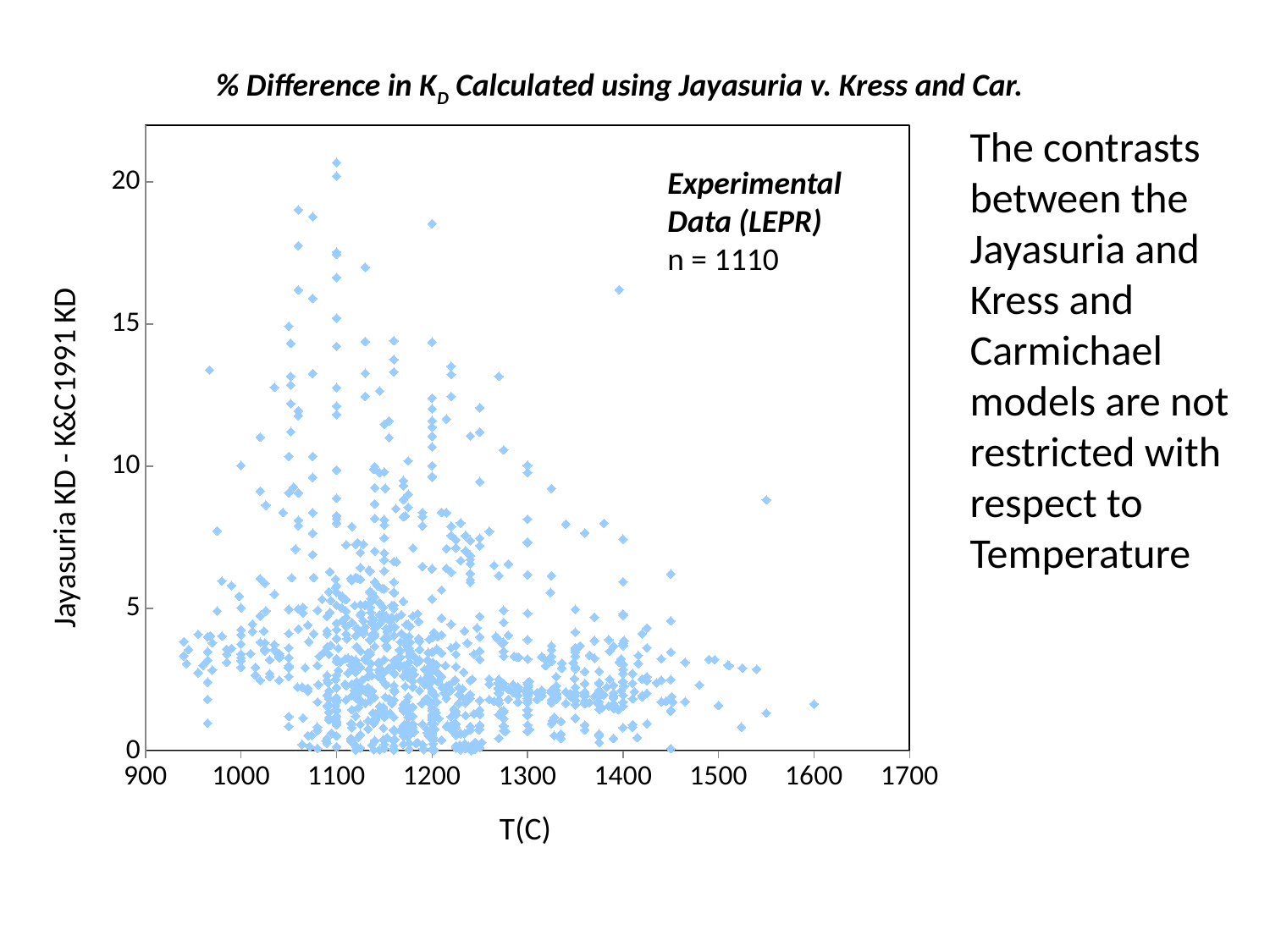
What is the label of the y axis? Jayasuria KD - K&C1991 KD Is the isolated point plotted near T = 1400 at the upper part of the chart greater or less than 15 on the y axis? greater Is the highest plotted value on the chart greater or less than 15? greater Are there any points plotted above 20 on the y axis? yes Do the plotted values generally rise or fall as temperature increases along the x axis? fall What is the label of the x axis? T(C) How many experimental data points does the chart state it contains (n)? 1110 What kind of chart is shown on the slide? scatter plot